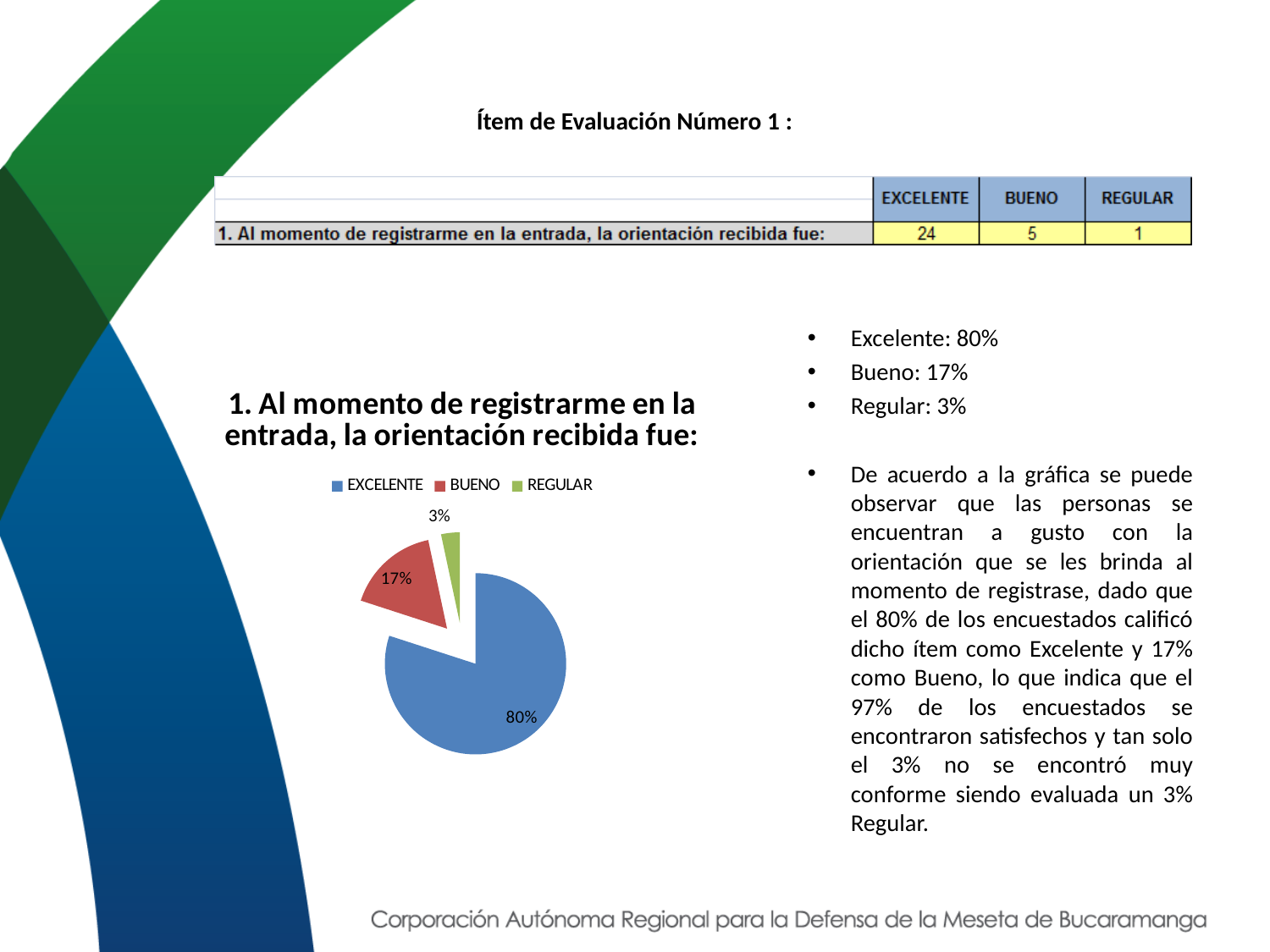
What kind of chart is shown on the slide? pie chart What share of the pie does REGULAR have? 3% What is the title of the pie chart? 1. Al momento de registrarme en la entrada, la orientación recibida fue: What share of the pie does BUENO have? 17% What colour is the EXCELENTE slice in the pie chart? blue Which category has the smallest slice of the pie? REGULAR Which category has the largest slice of the pie? EXCELENTE What is the difference in percentage points between the EXCELENTE and BUENO slices? 63 How many entries does the legend list? 3 Which is larger, the share for BUENO or the share for REGULAR? BUENO How many categories does the pie chart show? 3 What share of the pie does EXCELENTE have? 80%